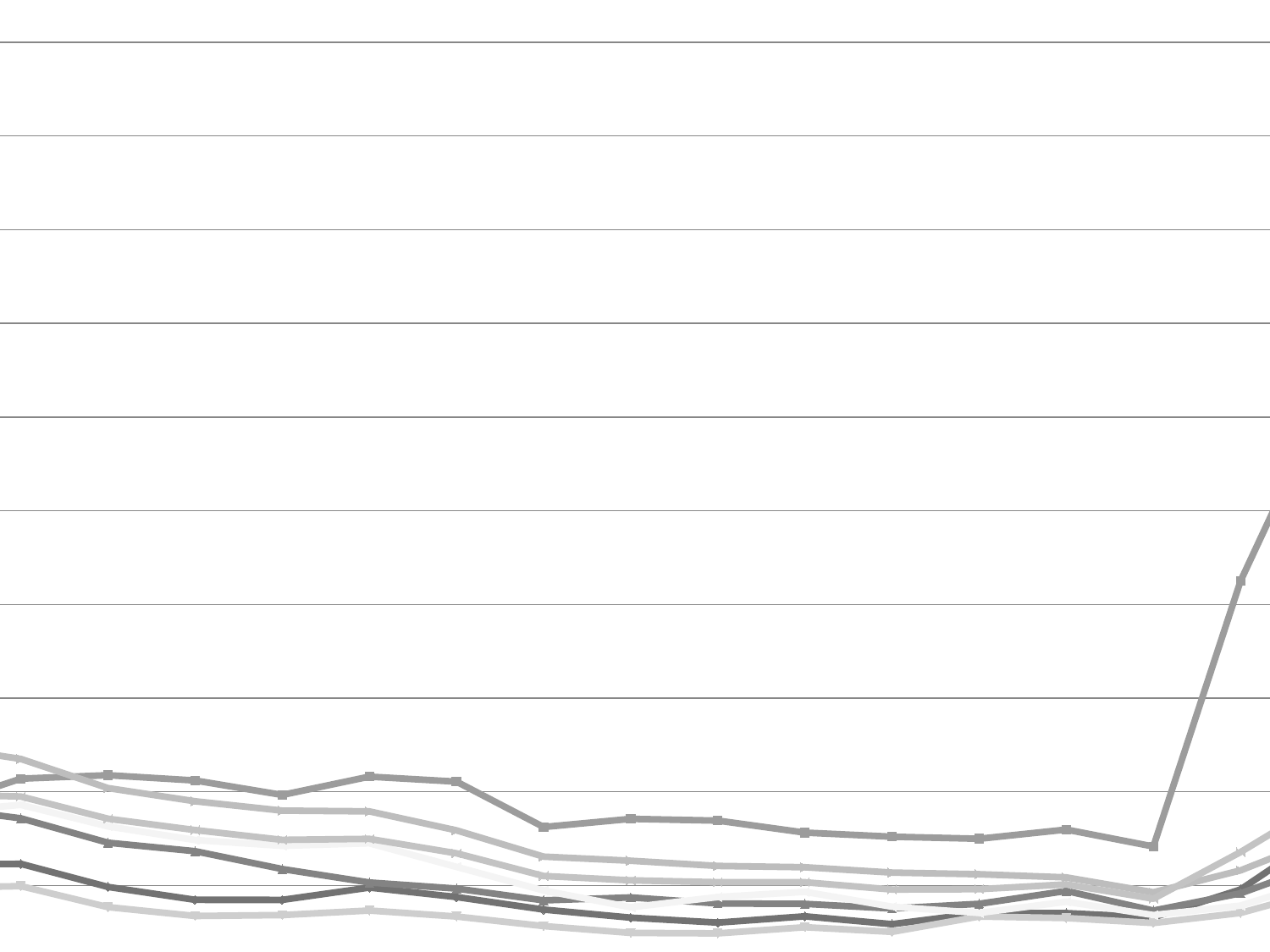
What kind of chart is shown on the slide? line chart Does the topmost line rise or fall sharply at the far right end of the chart? rise Does the chart display a legend identifying the series? no Are any axis labels or data labels printed on the chart? no